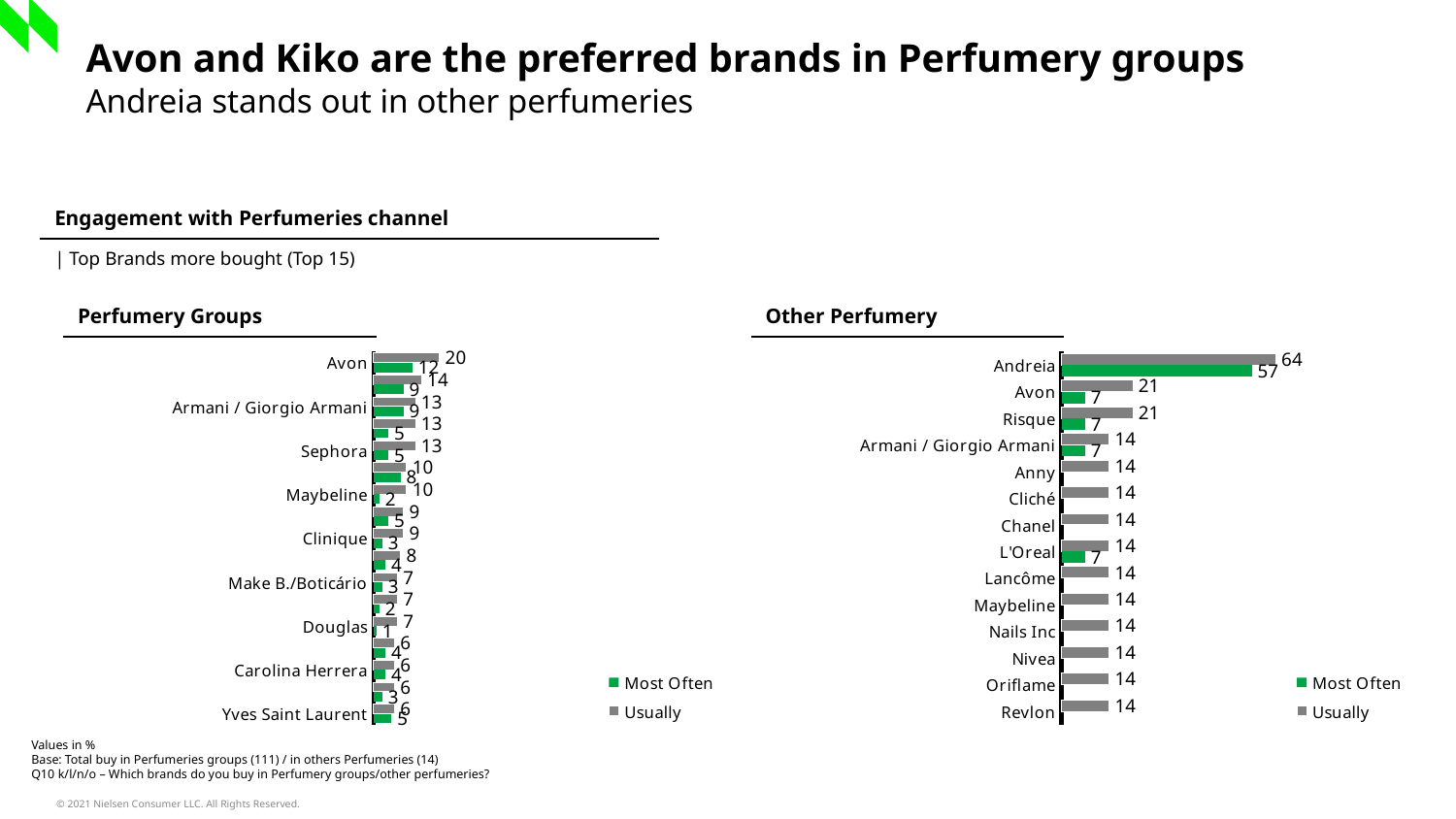
What type of chart is the Other Perfumery chart? Bar chart In the Other Perfumery chart, what is the Usually value for Risque? 21 In the Perfumery Groups chart, what is the Most Often value for Maybeline? 2 In the Perfumery Groups chart, which has the larger Usually value, Avon or Sephora? Avon In the Other Perfumery chart, what is the Most Often value for Andreia? 57 In the Other Perfumery chart, how many brands are listed? 14 In the Other Perfumery chart, which brand has the highest Usually value? Andreia How many series does the legend of the Perfumery Groups chart list? 2 In the Other Perfumery chart, what is the Usually value for Andreia? 64 In the Perfumery Groups chart, what is the Usually value for Avon? 20 In the Other Perfumery chart, what is the difference between the Usually and Most Often values for Andreia? 7 In the Perfumery Groups chart, what is the Most Often value for Avon? 12